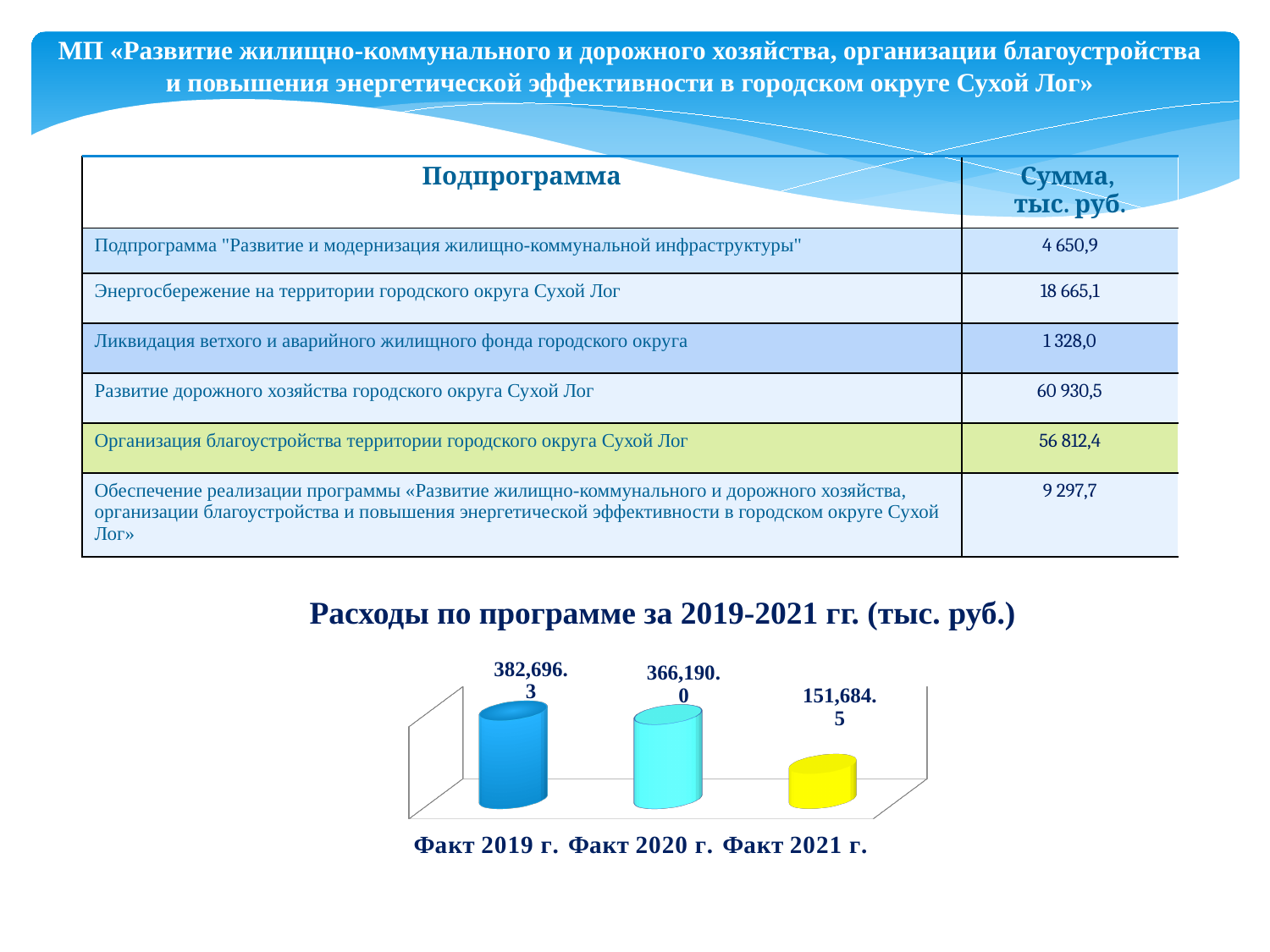
Which category has the lowest value in the chart? Факт 2021 г. How many categories are shown in the chart? 3 What is the difference between the values for Факт 2019 г. and Факт 2020 г.? 16,506.3 Do the values rise or fall from Факт 2019 г. to Факт 2021 г.? Fall What is the title of the chart? Расходы по программе за 2019-2021 гг. (тыс. руб.) What is the value for Факт 2021 г. in the chart? 151,684.5 Which is larger, the value for Факт 2020 г. or the value for Факт 2021 г.? Факт 2020 г. Which category has the highest value in the chart? Факт 2019 г. What is the value for Факт 2020 г. in the chart? 366,190.0 What is the value for Факт 2019 г. in the chart? 382,696.3 What kind of chart is shown on the slide? Bar chart What is the difference between the values for Факт 2020 г. and Факт 2021 г.? 214,505.5